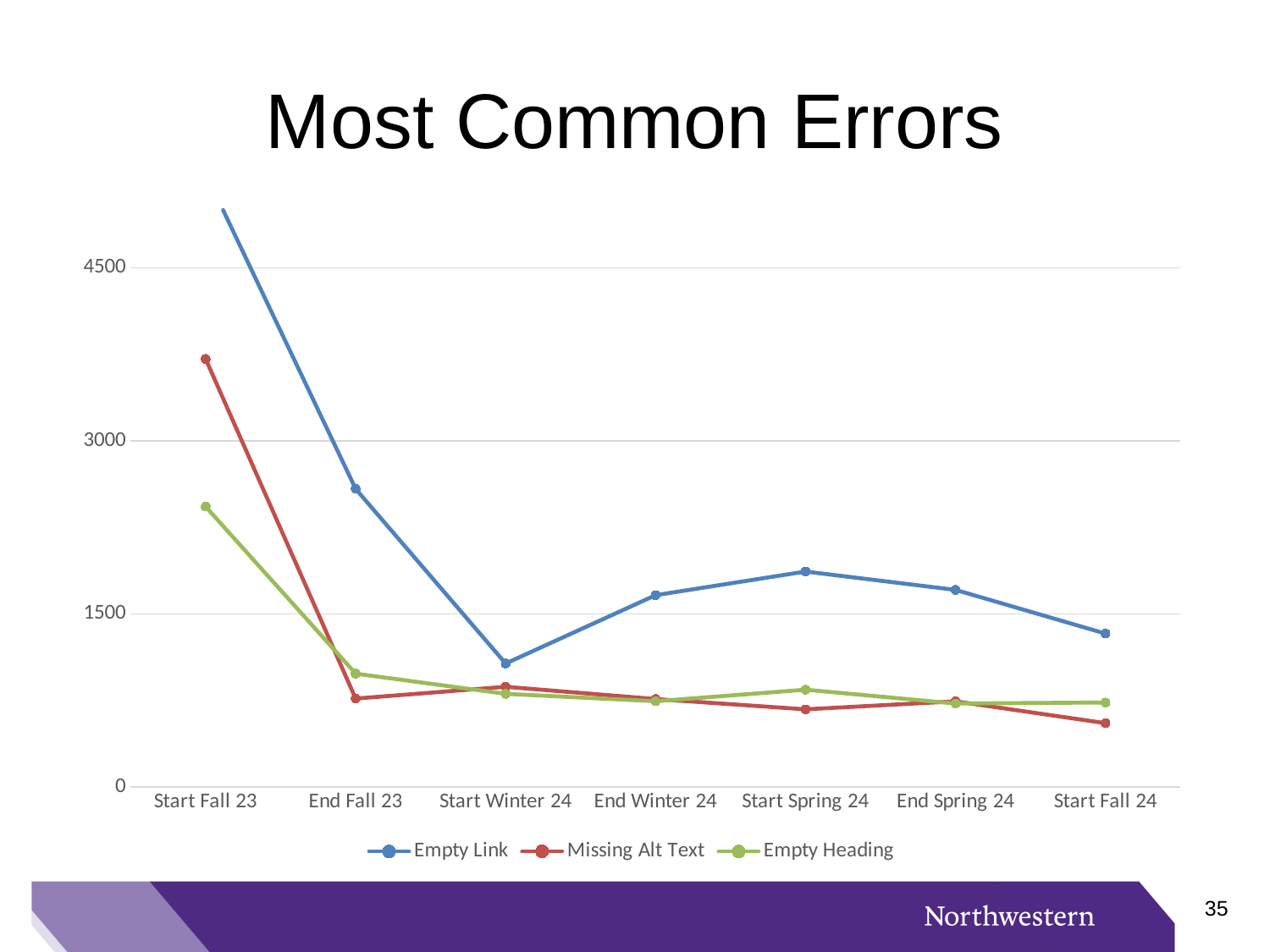
What is the title of the chart? Most Common Errors At which time point is the Empty Link series lowest? Start Winter 24 At which time point is the Empty Link series highest? Start Fall 23 At Start Spring 24, which is larger: Empty Link or Missing Alt Text? Empty Link What kind of chart is shown on the slide? Line chart Which series is drawn in blue? Empty Link Is the value for Empty Heading at Start Fall 23 greater or less than 3000? less How many series does the legend list? 3 Does the Missing Alt Text series rise or fall from Start Fall 23 to Start Fall 24? Fall At which time point is the Missing Alt Text series lowest? Start Fall 24 Is the value for Empty Link at Start Fall 23 greater or less than 4500? greater How many time points are shown along the x axis? 7